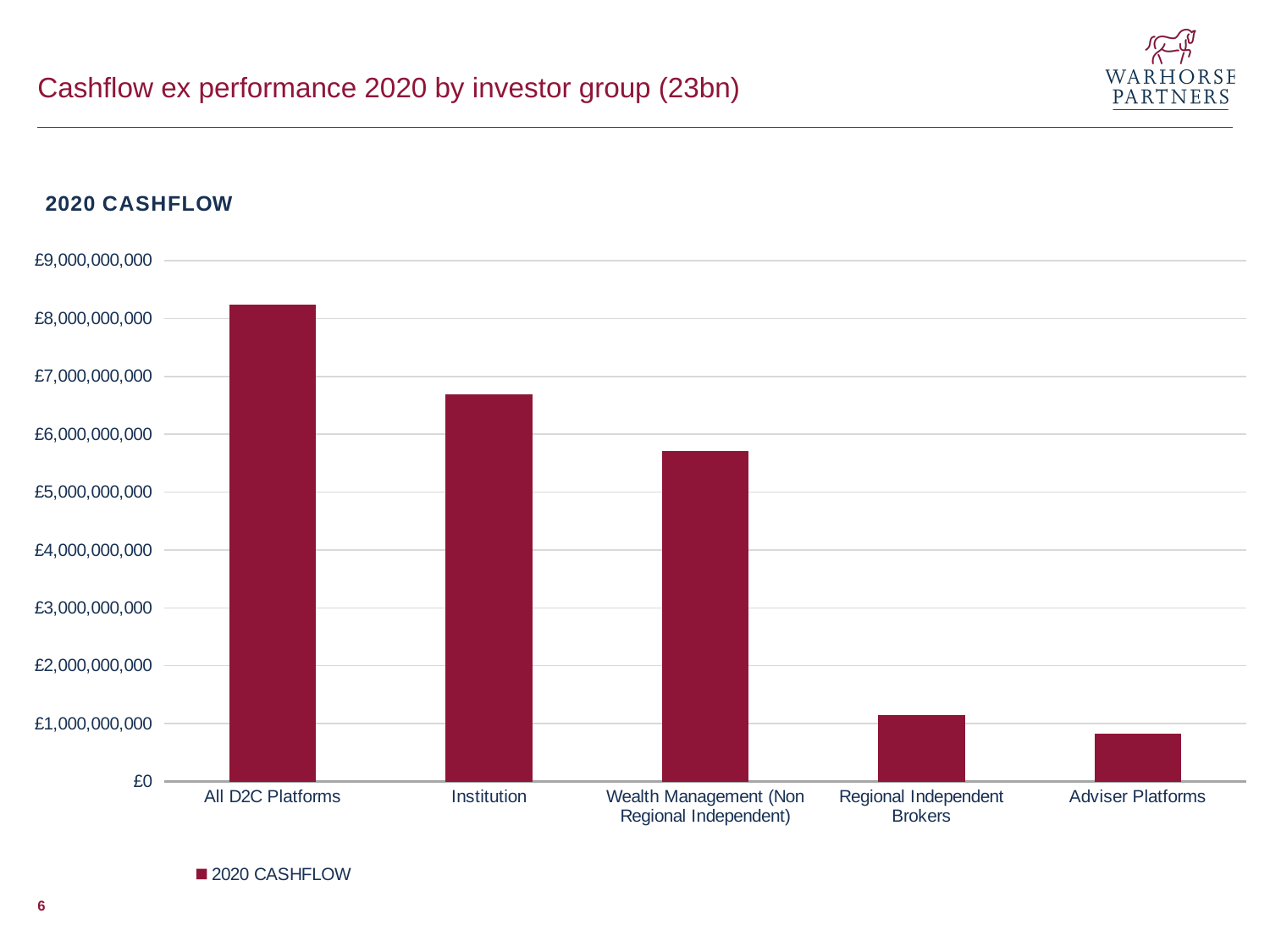
Which is larger, the value for Institution or the value for Wealth Management (Non Regional Independent)? Institution Do the values rise or fall moving from left to right along the x axis? fall What is the title of the chart? 2020 CASHFLOW Is the value for Institution greater or less than £7,000,000,000? less How many investor groups are shown on the x axis? 5 Is the value for Adviser Platforms greater or less than £1,000,000,000? less Is the value for All D2C Platforms greater or less than £8,000,000,000? greater Which investor group has the highest 2020 cashflow? All D2C Platforms What kind of chart is shown on the slide? Bar chart How many series does the legend list? 1 Which investor group has the lowest 2020 cashflow? Adviser Platforms